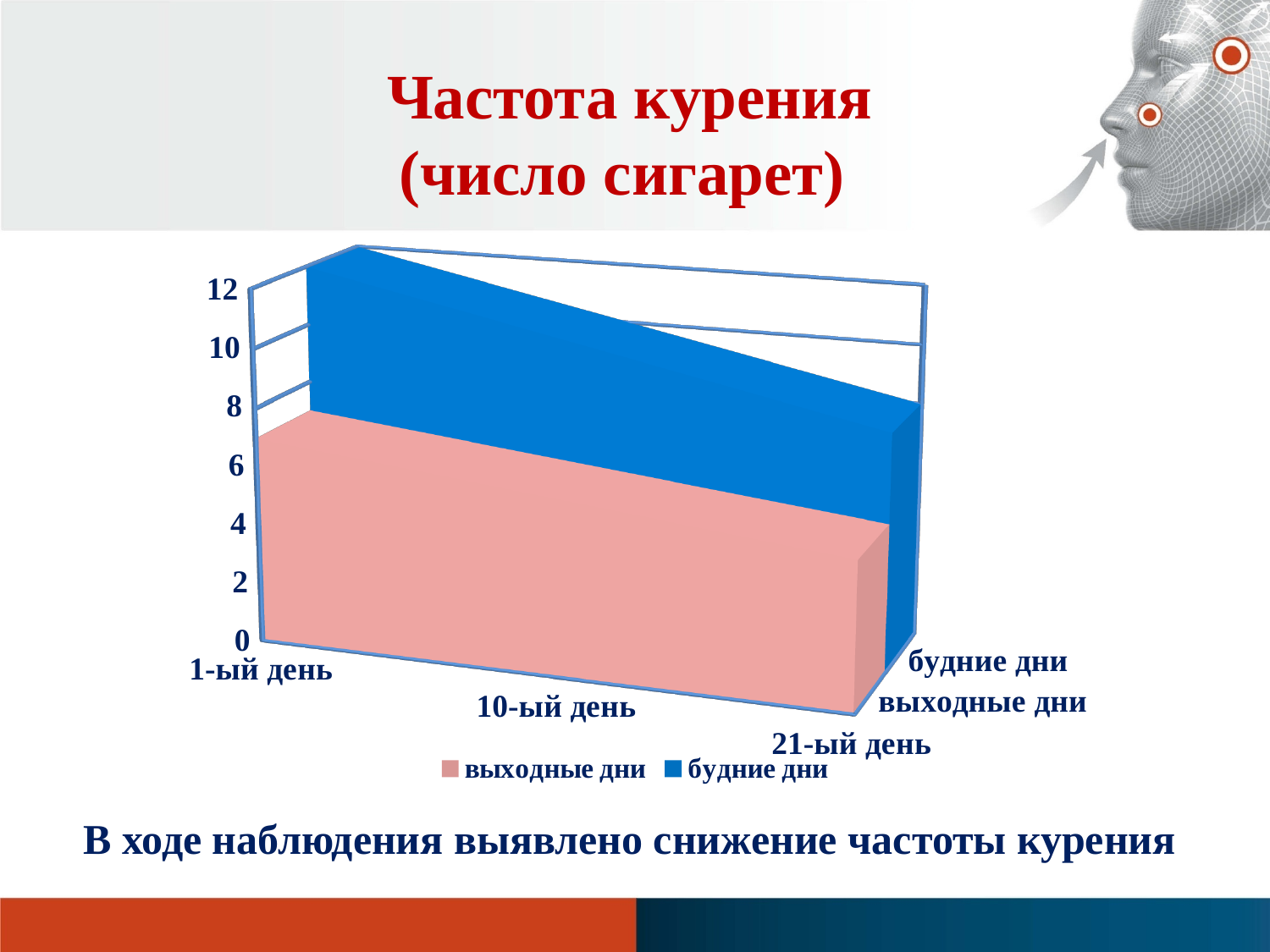
Which series has the larger value on 21-ый день, будние дни or выходные дни? будние дни What is the title of the chart? Частота курения (число сигарет) Is the value for будние дни on 1-ый день greater or less than 10? greater What kind of chart is shown on the slide? area chart How many series does the legend list? 2 How many categories are shown on the x axis? 3 Which series is shown in blue? будние дни Do the values for будние дни rise or fall from 1-ый день to 21-ый день? fall Is the value for выходные дни on 21-ый день greater or less than 8? less Which series has the larger value on 1-ый день, будние дни or выходные дни? будние дни Is the value for выходные дни on 1-ый день greater or less than 4? greater Do the values for выходные дни rise or fall from 1-ый день to 21-ый день? fall